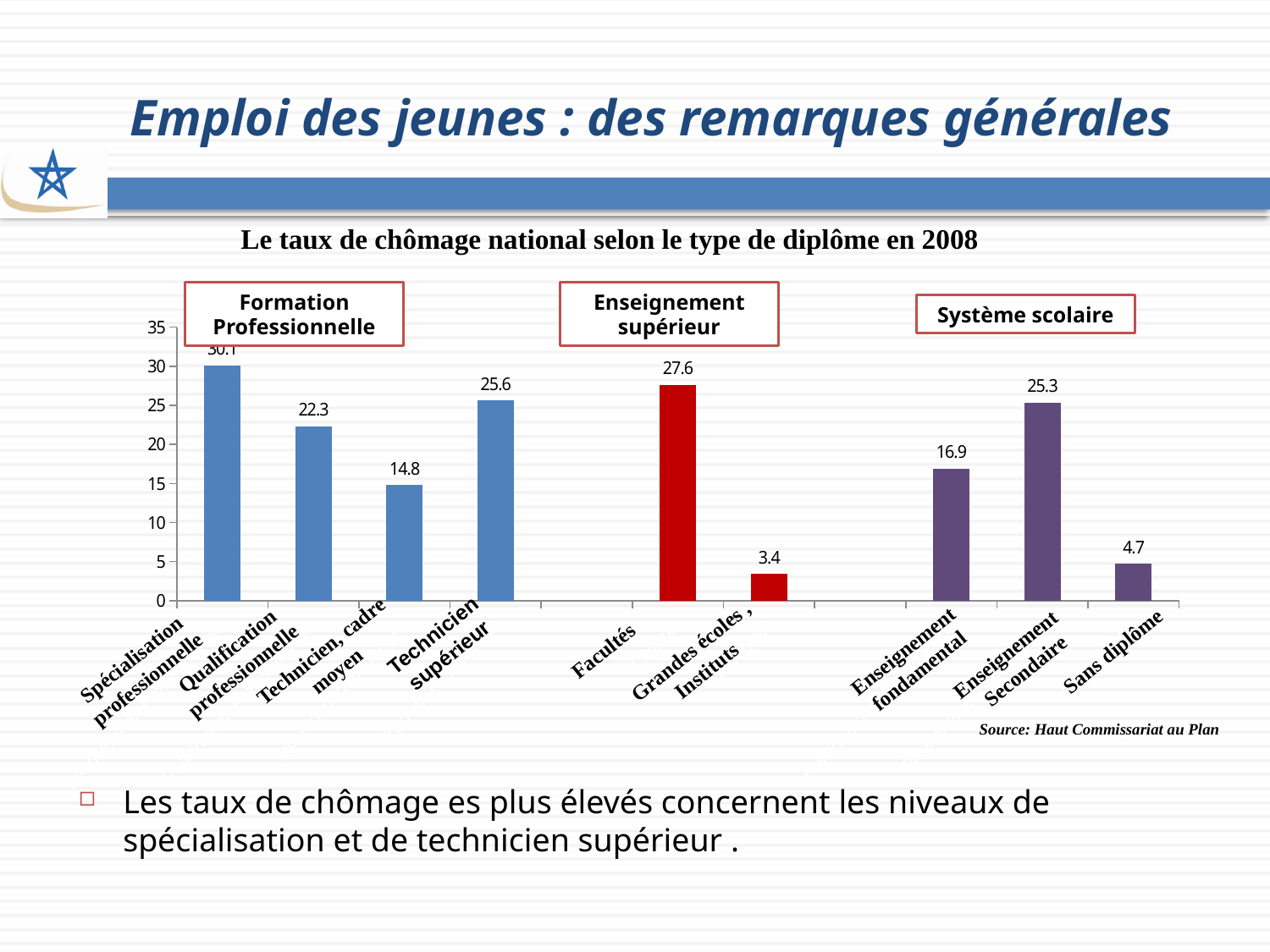
What is the value shown for Enseignement fondamental? 16.9 Which is larger, the value for Facultés or the value for Enseignement Secondaire? Facultés What is the title of the chart? Le taux de chômage national selon le type de diplôme en 2008 What is the difference between the values for Qualification professionnelle and Technicien, cadre moyen? 7.5 How many categories (bars) are plotted in the chart? 9 Which category has the highest unemployment rate? Spécialisation professionnelle What is the unemployment rate shown for Facultés? 27.6 What kind of chart is shown on the slide? bar chart Is the value for Enseignement fondamental greater or less than 20? less Which category has the lowest unemployment rate? Grandes écoles, Instituts What is the value shown for Sans diplôme? 4.7 What is the value shown for Technicien supérieur? 25.6